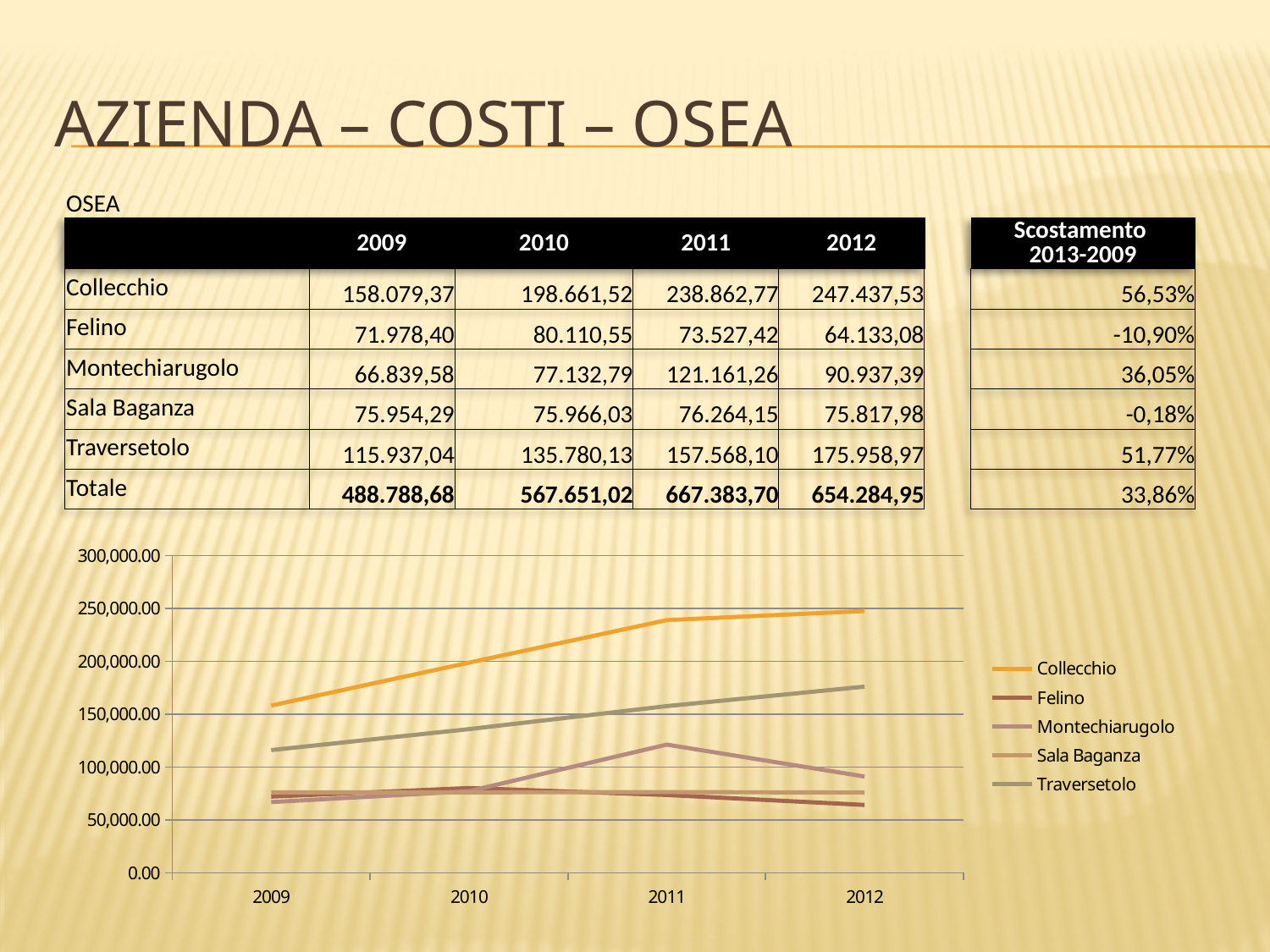
What kind of chart is shown on the slide? line chart Which series has the highest value in 2012 on the chart? Collecchio Does the Felino line rise or fall from 2010 to 2012? fall Is the value for Collecchio in 2011 greater or less than 200,000.00? greater Is the value for Traversetolo in 2009 greater or less than 150,000.00? less How many years are shown along the x axis of the chart? 4 Does the Collecchio line rise or fall from 2009 to 2012? rise According to the table, what is the value for Collecchio in 2012? 247.437,53 In 2011, which is larger: Montechiarugolo or Traversetolo? Traversetolo Which series has the lowest value in 2012 on the chart? Felino Using the table values, what is the difference between Collecchio's 2012 and 2009 values? 89.358,16 How many series does the chart's legend list? 5